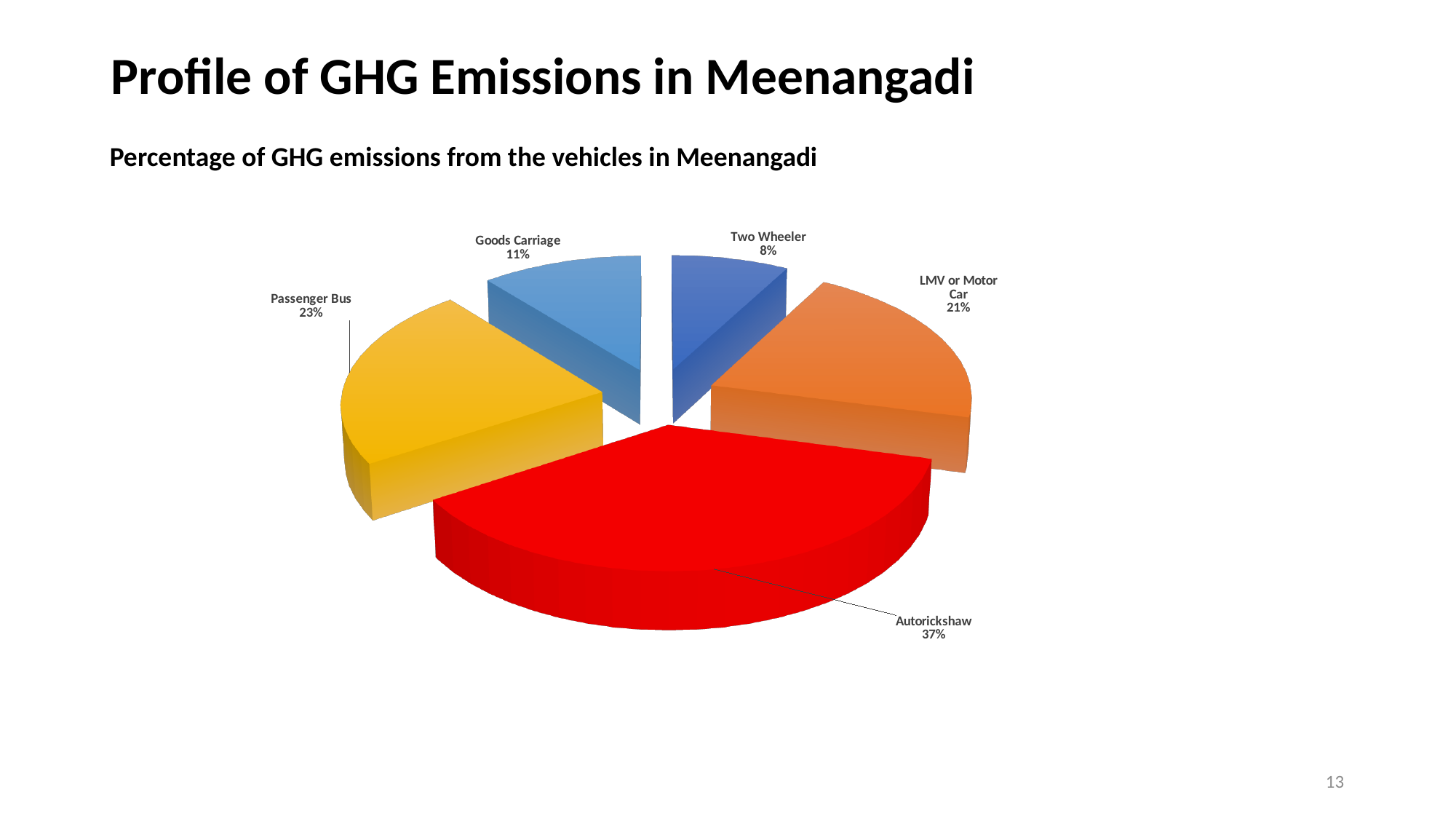
Which vehicle category has the smallest share of GHG emissions? Two Wheeler What kind of chart is shown on the slide? Pie chart What percentage of GHG emissions comes from LMV or Motor Car? 21% What percentage of GHG emissions comes from Goods Carriage? 11% What percentage of GHG emissions comes from Autorickshaw? 37% What percentage of GHG emissions comes from Two Wheeler? 8% Which vehicle category has the largest share of GHG emissions? Autorickshaw What colour is the Autorickshaw slice? Red What is the difference in percentage points between Autorickshaw and Passenger Bus? 14 Which has a larger share of GHG emissions, Goods Carriage or Two Wheeler? Goods Carriage What percentage of GHG emissions comes from Passenger Bus? 23% How many vehicle categories are shown in the pie chart? 5